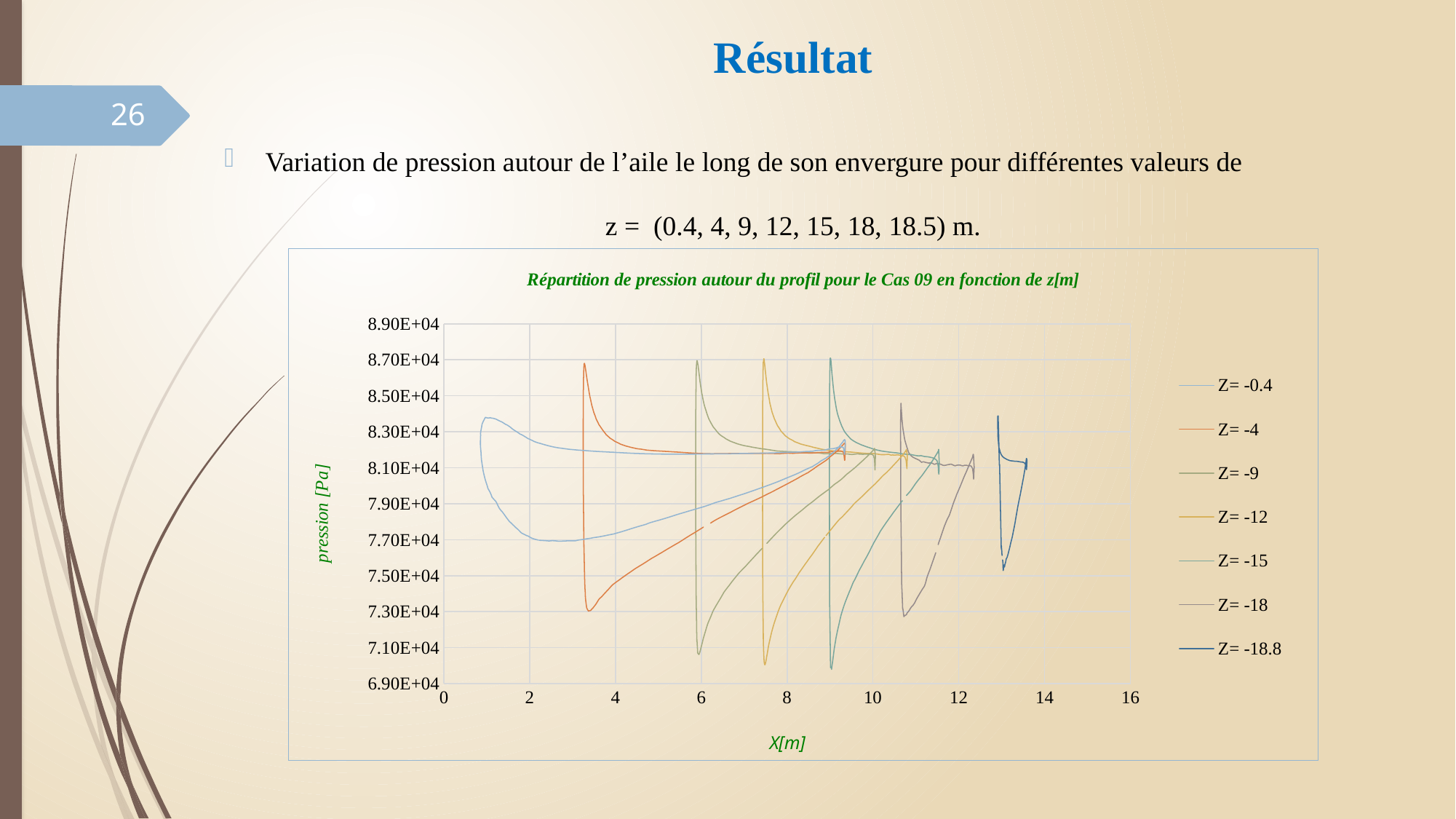
What is the title of the chart? Répartition de pression autour du profil pour le Cas 09 en fonction de z[m] How many series does the legend list? 7 What kind of chart is shown on the slide? line chart Is the lowest pressure of the Z= -4 series greater or less than 7.50E+04? less What is the label of the y axis? pression [Pa] Which series is plotted at the largest X values? Z= -18.8 Is the peak pressure of the Z= -9 series greater or less than 8.50E+04? greater What is the highest value shown on the y axis? 8.90E+04 Which series is plotted at the smallest X values? Z= -0.4 Is the lowest pressure of the Z= -0.4 series greater or less than 7.50E+04? greater